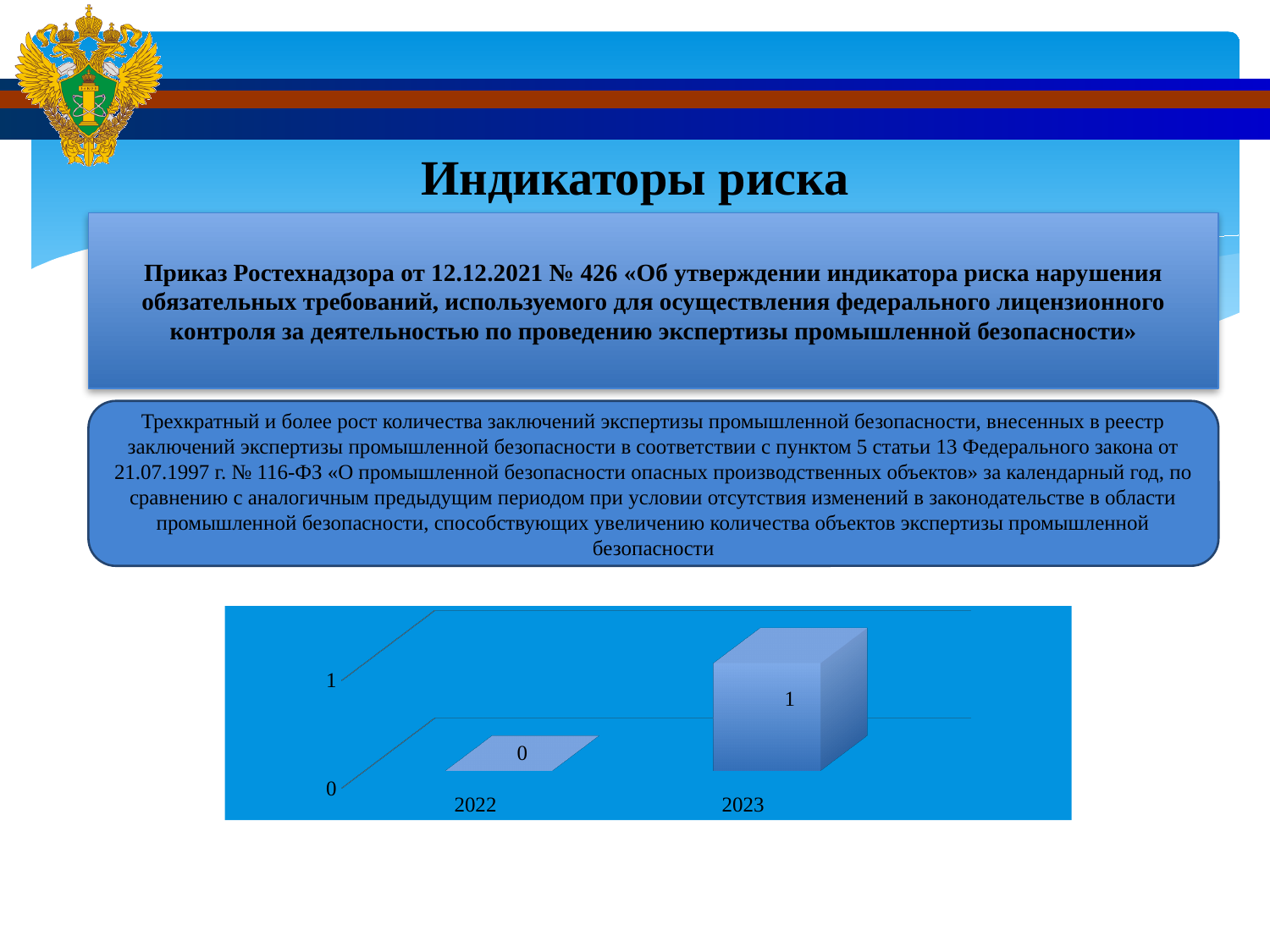
Which year has the highest value in the chart? 2023 Do the values rise or fall from 2022 to 2023? rise What is the highest tick value shown on the vertical axis of the chart? 1 Which year has the lowest value in the chart? 2022 How many categories are shown on the x axis of the chart? 2 What is the difference between the values for 2023 and 2022? 1 What is the total of the values for 2022 and 2023? 1 What colour are the bars in the chart? blue Which is larger, the value for 2022 or the value for 2023? 2023 What is the value for 2023 in the chart? 1 What is the value for 2022 in the chart? 0 What kind of chart is shown on the slide? bar chart